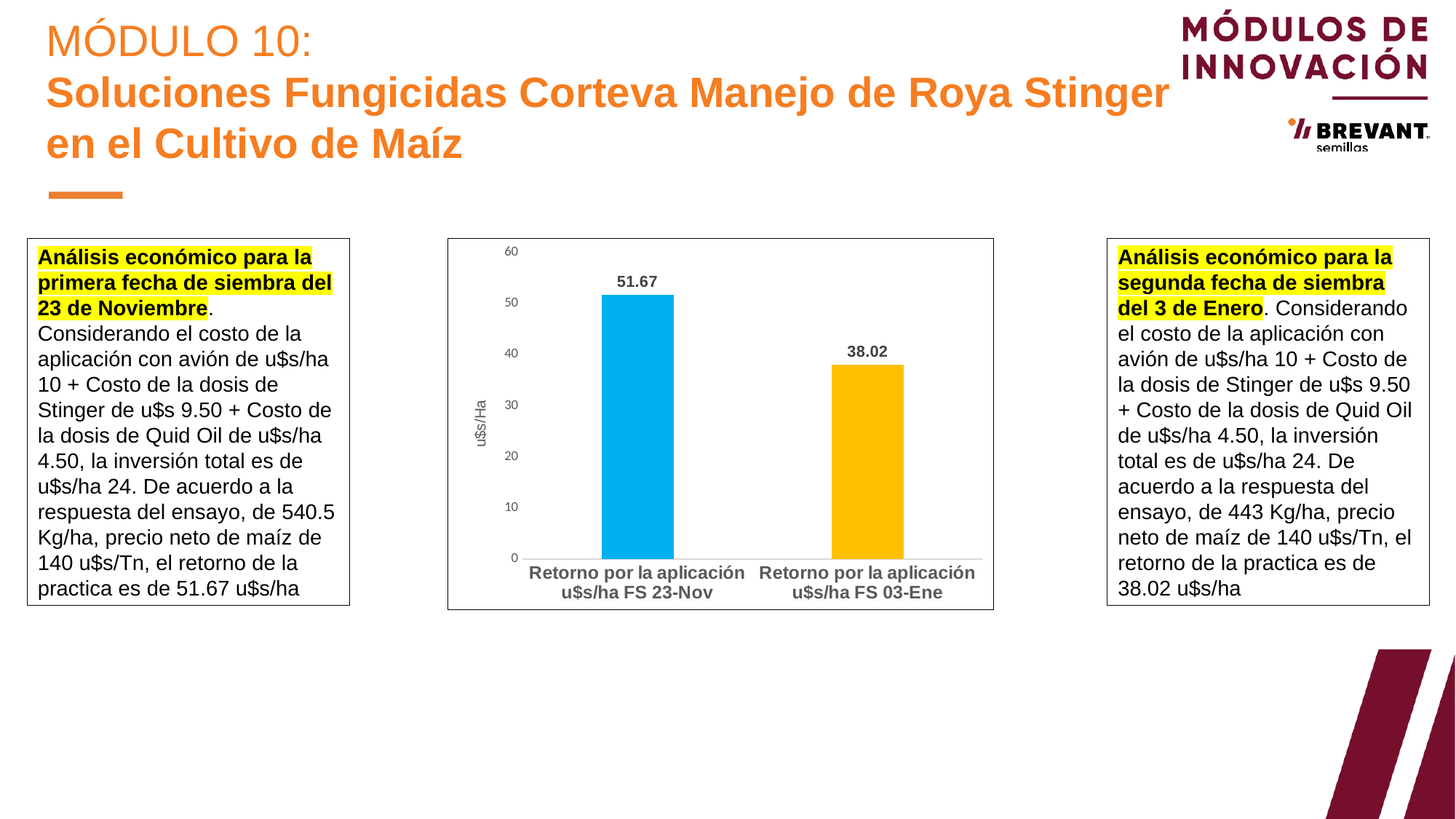
Which category has the lowest value? Retorno por la aplicación u$s/ha FS 03-Ene What kind of chart is shown on the slide? bar chart Which is larger, the value for FS 23-Nov or the value for FS 03-Ene? FS 23-Nov Which category has the highest value? Retorno por la aplicación u$s/ha FS 23-Nov What is the difference between the FS 23-Nov value and the FS 03-Ene value? 13.65 What colour is the bar for FS 03-Ene? yellow Is the value for FS 03-Ene greater or less than 40? less What is the value for 'Retorno por la aplicación u$s/ha FS 03-Ene'? 38.02 How many bars are plotted in the chart? 2 Is the value for FS 23-Nov greater or less than 50? greater What is the value for 'Retorno por la aplicación u$s/ha FS 23-Nov'? 51.67 What is the label of the vertical axis? u$s/Ha